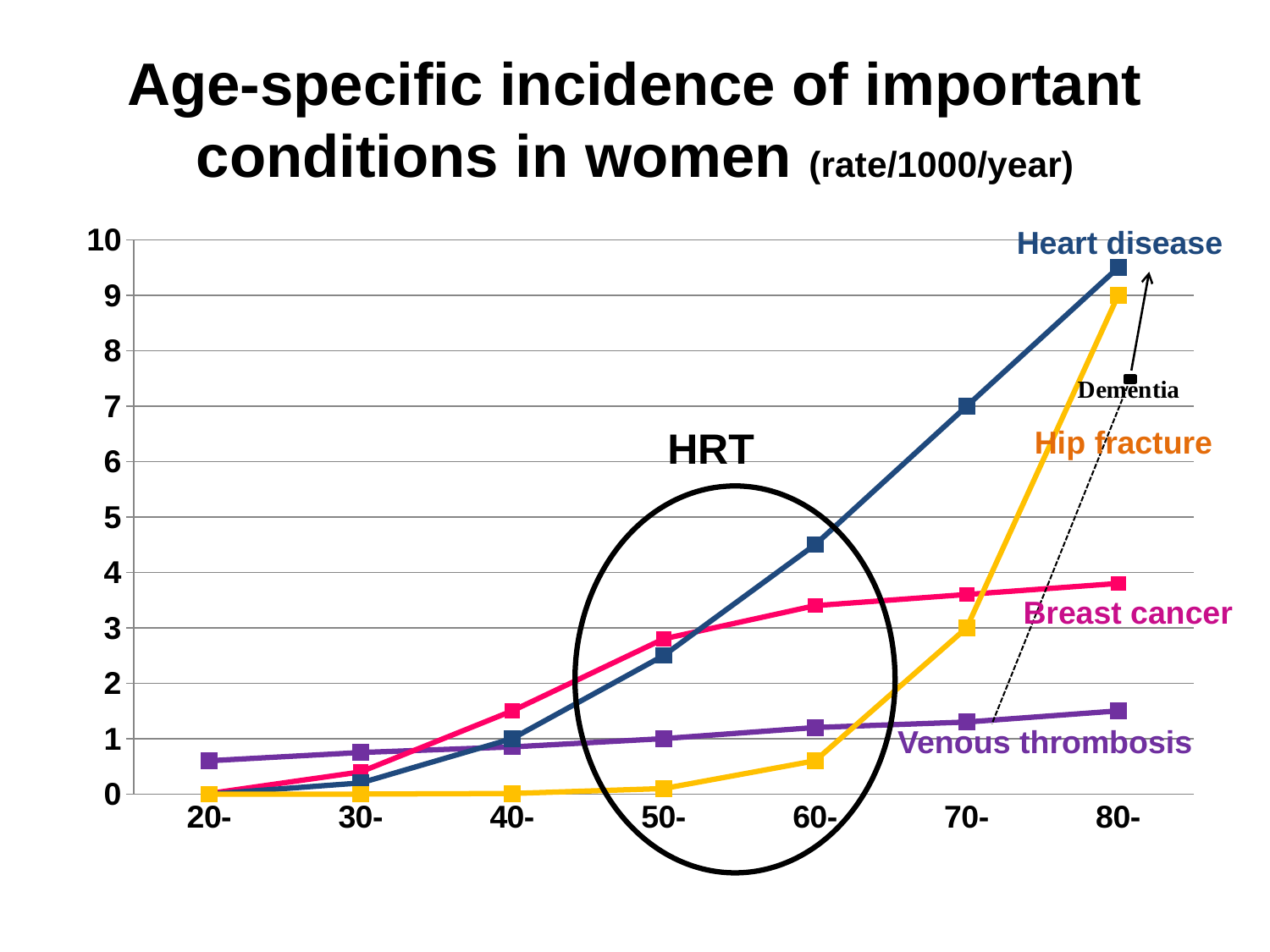
What is the value for Heart disease at age 70-? 7 At age 60-, which is higher: Heart disease or Breast cancer? Heart disease How many age groups are shown on the x axis? 7 Does the Heart disease line rise or fall as age increases? rises What is the value for Venous thrombosis at age 50-? 1 Is the value for Breast cancer at age 80- greater or less than 4? less What label is written above the circled region of the chart? HRT Which condition has the lowest value at age 80-? Venous thrombosis What kind of chart is shown on the slide? line chart What is the value for Hip fracture at age 70-? 3 Is the value for Heart disease at age 60- greater or less than 4? greater What is the value for Hip fracture at age 80-? 9